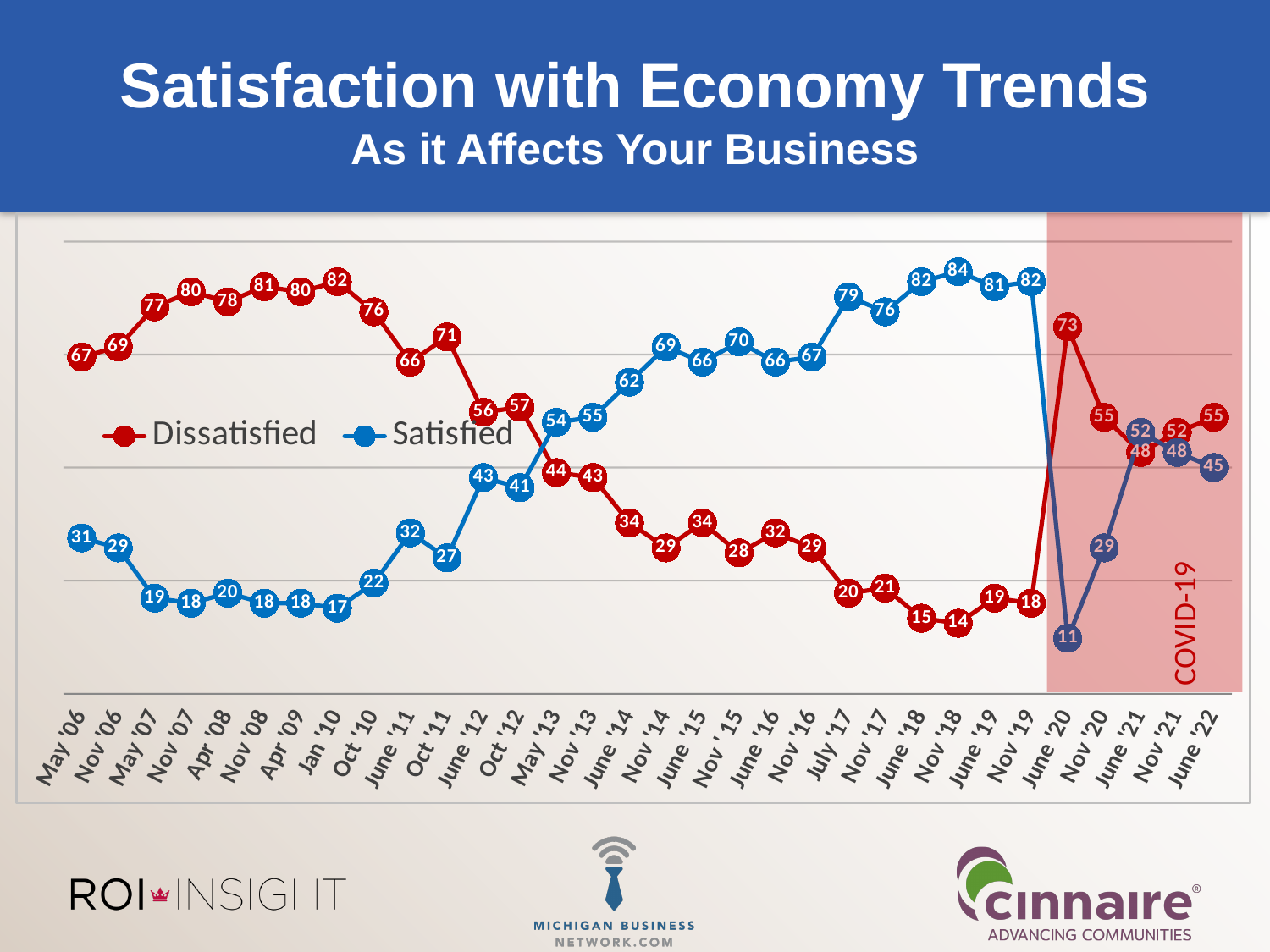
What label is written in the shaded region at the right of the chart? COVID-19 At which date does the Satisfied series reach its highest value? Nov '18 What is the Dissatisfied value for Jan '10? 82 What is the Satisfied value for Nov '18? 84 What is the difference between the Dissatisfied and Satisfied values for June '22? 10 Does the Satisfied series rise or fall from May '06 to Jan '10? Fall At which date does the Satisfied series reach its lowest value? June '20 What kind of chart is shown on the slide? Line chart How many dates are plotted along the x axis? 32 For Nov '19, which series has the larger value, Satisfied or Dissatisfied? Satisfied How many series does the legend list? 2 What is the Dissatisfied value for June '20? 73